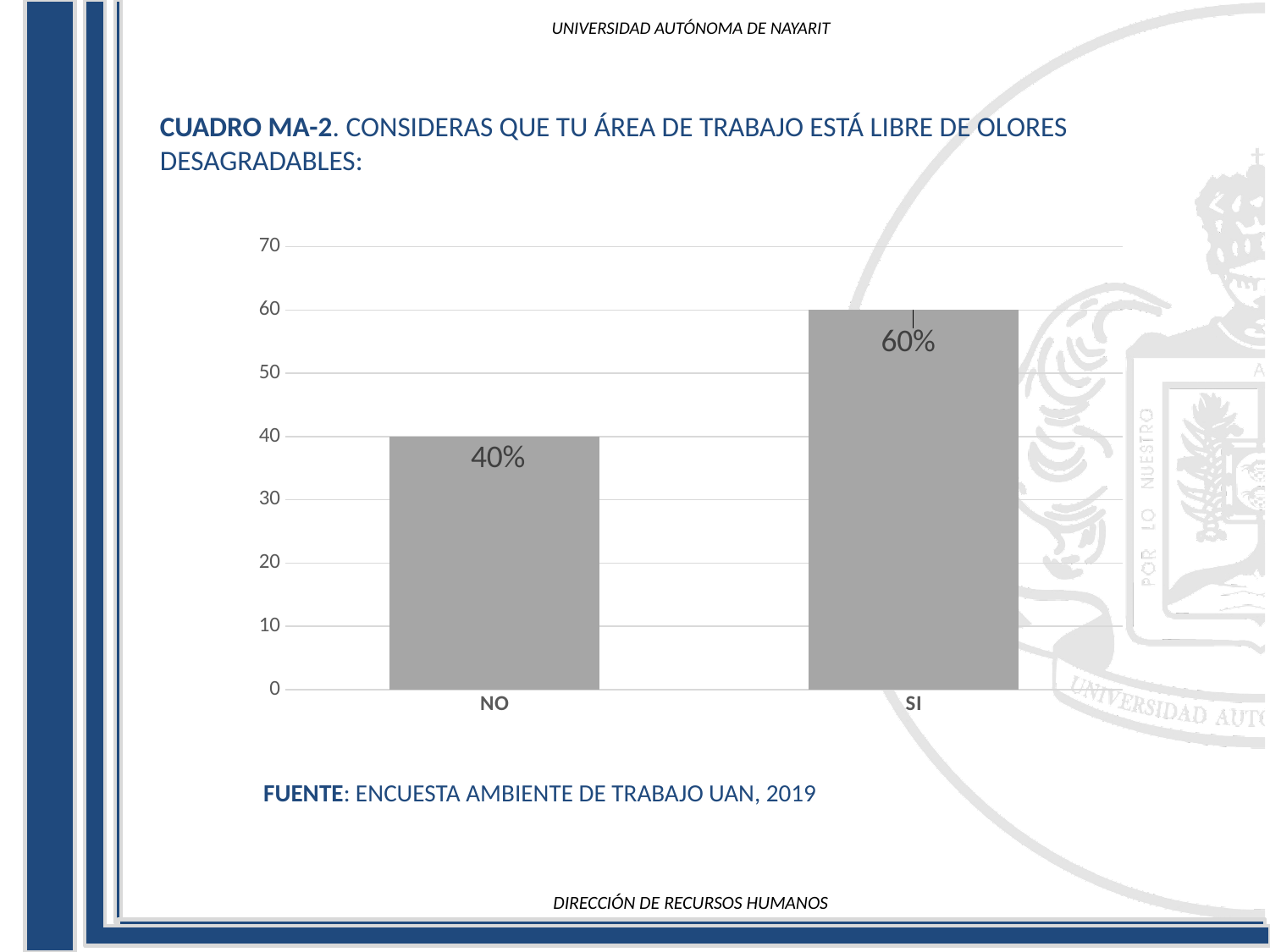
What is the difference between the values for SI and NO? 20% Which category has the highest value? SI How many categories are shown on the x axis? 2 What is the source cited below the chart? ENCUESTA AMBIENTE DE TRABAJO UAN, 2019 What is the value for NO? 40% Is the value for NO greater or less than 50? less Which category has the lowest value? NO Is the value for SI greater or less than 50? greater What kind of chart is shown on the slide? bar chart What is the value for SI? 60% Which is larger, the value for NO or the value for SI? SI Do the values rise or fall from NO to SI? rise